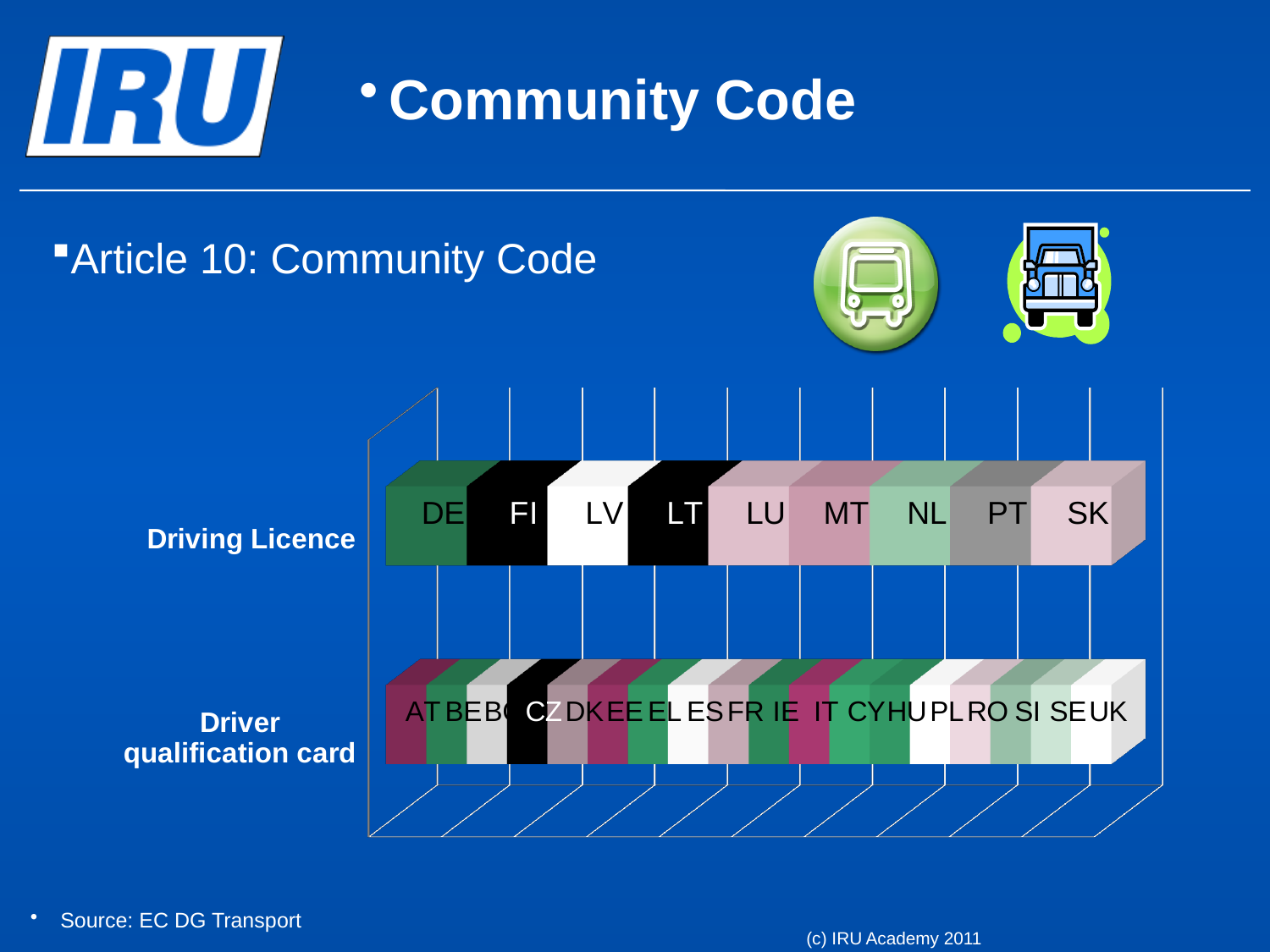
How many country segments make up the Driver qualification card bar? 18 What kind of chart is shown on the slide? Bar chart Which country code is the first segment of the Driver qualification card bar? AT How many categories (bars) does the chart show? 2 What are the two categories labelled on the chart? Driving Licence and Driver qualification card Which country code is the last segment of the Driver qualification card bar? UK How many country segments make up the Driving Licence bar? 9 Which country codes are shown in the Driving Licence bar? DE, FI, LV, LT, LU, MT, NL, PT, SK In which bar does the country code FR appear? Driver qualification card